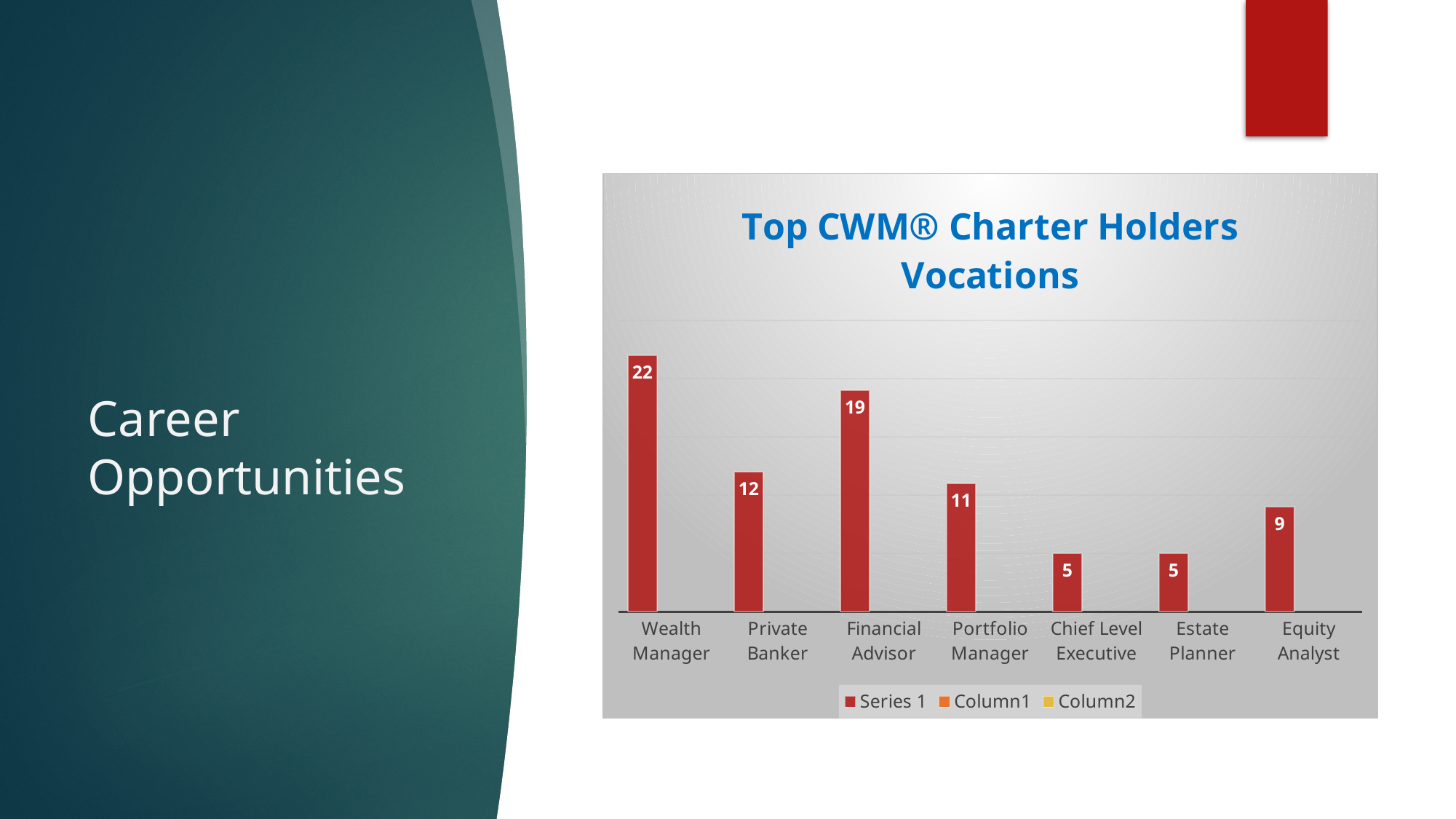
What is the value for Equity Analyst? 9 What is the difference between the values for Wealth Manager and Private Banker? 10 What is the value for Financial Advisor? 19 Which is larger, the value for Portfolio Manager or the value for Equity Analyst? Portfolio Manager What is the value for Wealth Manager? 22 What kind of chart is shown? Bar chart What is the difference between the values for Financial Advisor and Portfolio Manager? 8 What is the value for Chief Level Executive? 5 How many vocations are shown on the x axis? 7 What is the title of the chart? Top CWM® Charter Holders Vocations Which vocation has the highest value? Wealth Manager How many series does the legend list? 3